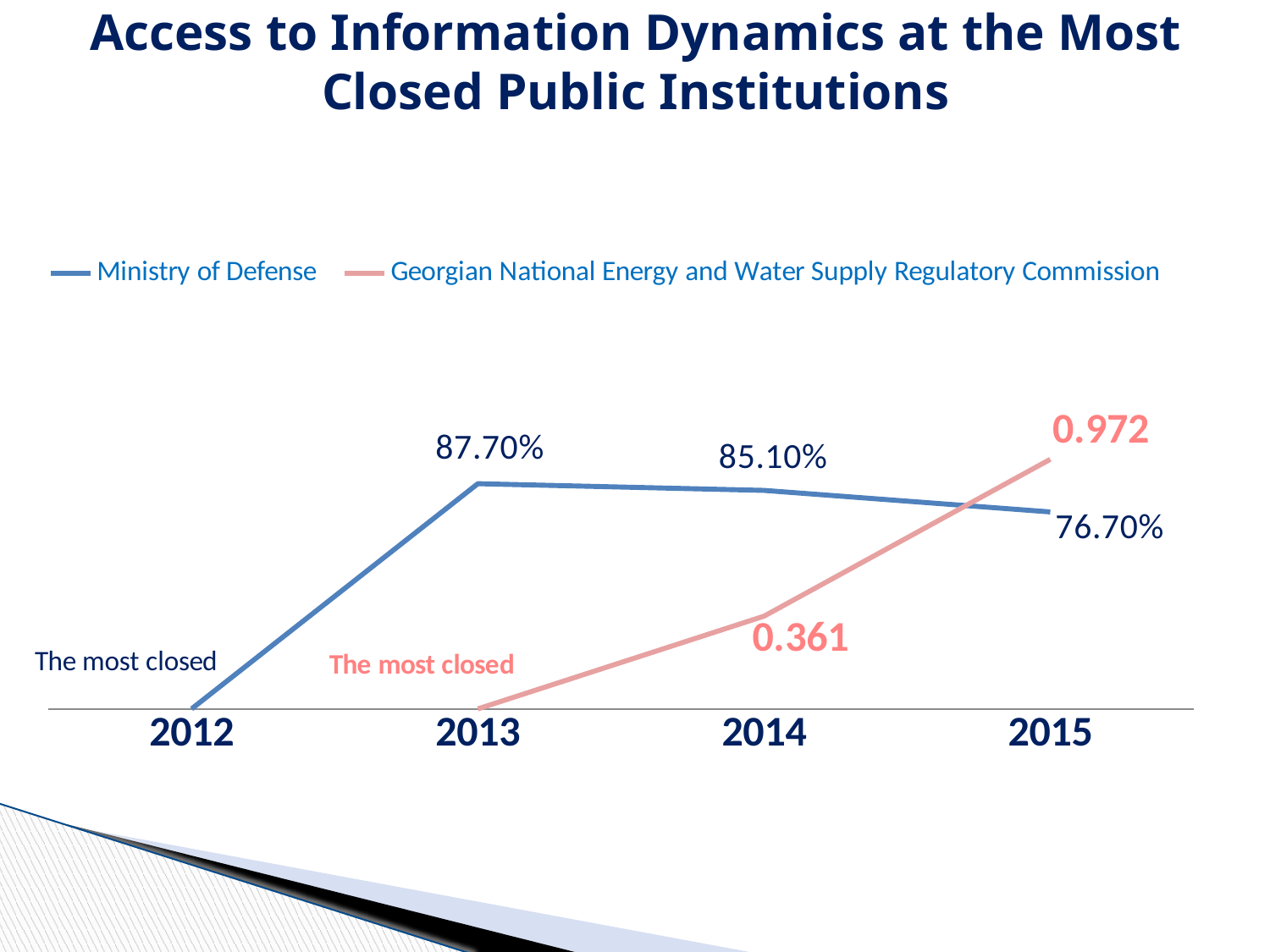
What is the difference between the Ministry of Defense values in 2013 and 2015? 11.00% In which year does the Ministry of Defense line reach its highest value? 2013 What is the value for Ministry of Defense in 2015? 76.70% What type of chart is shown on the slide? line chart What is the value for Ministry of Defense in 2014? 85.10% How many series does the legend list? 2 What is the value for Ministry of Defense in 2013? 87.70% What label is shown for the Ministry of Defense at 2012 instead of a value? The most closed Does the Ministry of Defense line rise or fall from 2013 to 2015? fall What is the value for Georgian National Energy and Water Supply Regulatory Commission in 2014? 0.361 How many years are shown on the x axis? 4 What is the value for Georgian National Energy and Water Supply Regulatory Commission in 2015? 0.972